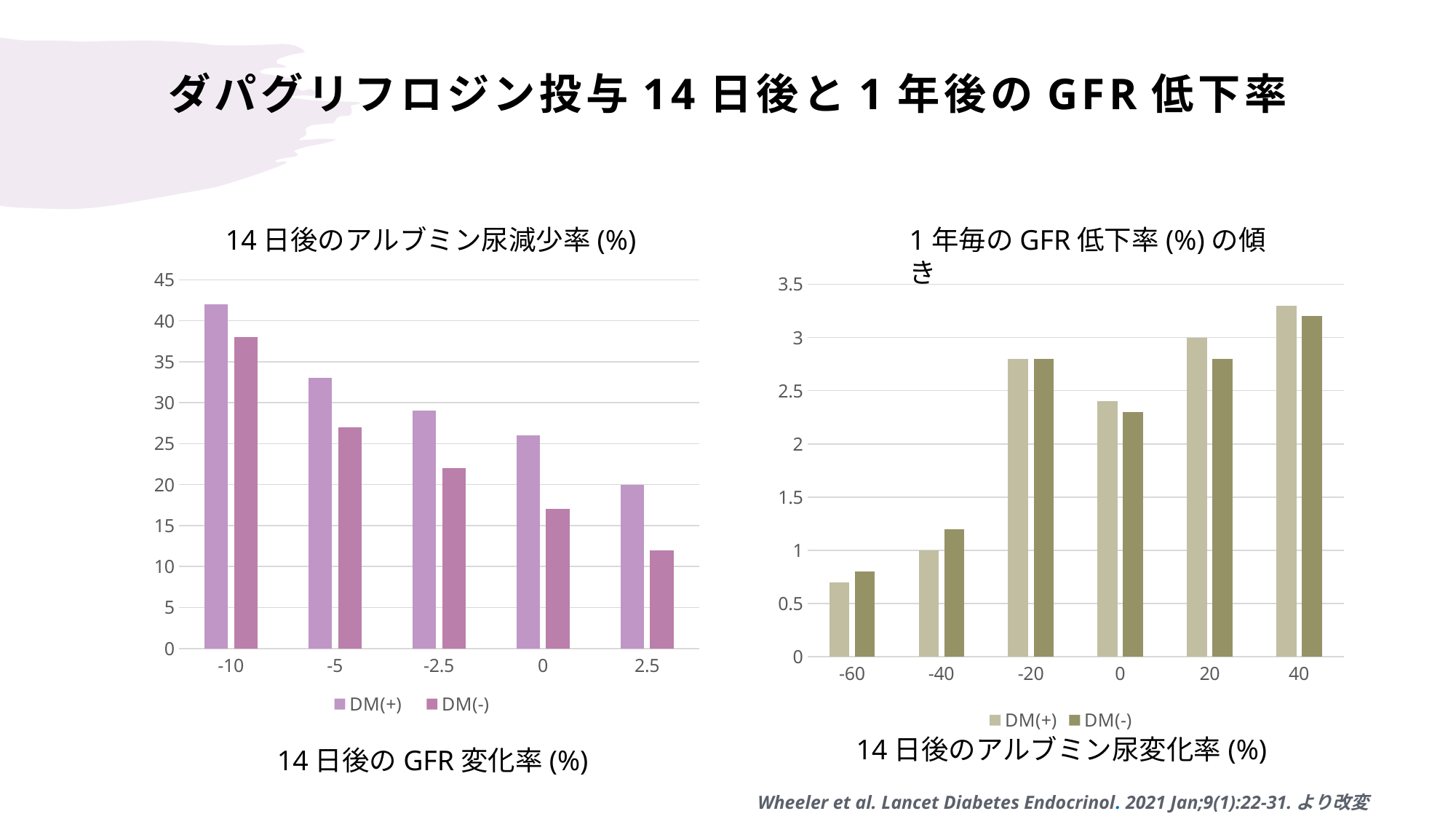
In the left chart (14 日後のアルブミン尿減少率 (%)), do the DM(+) values rise or fall from -10 to 2.5 along the x axis? fall In the left chart (14 日後のアルブミン尿減少率 (%)), how many categories are shown on the x axis? 5 In the right chart (1 年毎の GFR 低下率 (%) の傾き), which category has the lowest DM(+) value? -60 In the right chart (1 年毎の GFR 低下率 (%) の傾き), is the DM(-) value at -60 greater or less than 1? less In the left chart (14 日後のアルブミン尿減少率 (%)), how many series does the legend list? 2 In the left chart (14 日後のアルブミン尿減少率 (%)), is the DM(+) value at -10 greater or less than 40? greater In the right chart (1 年毎の GFR 低下率 (%) の傾き), which category has the highest DM(+) value? 40 In the left chart (14 日後のアルブミン尿減少率 (%)), at category -5, which series has the larger value, DM(+) or DM(-)? DM(+) In the left chart (14 日後のアルブミン尿減少率 (%)), which category has the highest DM(+) value? -10 In the right chart (1 年毎の GFR 低下率 (%) の傾き), how many categories are shown on the x axis? 6 What kind of chart is the left chart titled 14 日後のアルブミン尿減少率 (%)? bar chart In the right chart (1 年毎の GFR 低下率 (%) の傾き), what are the two legend entries? DM(+) and DM(-)